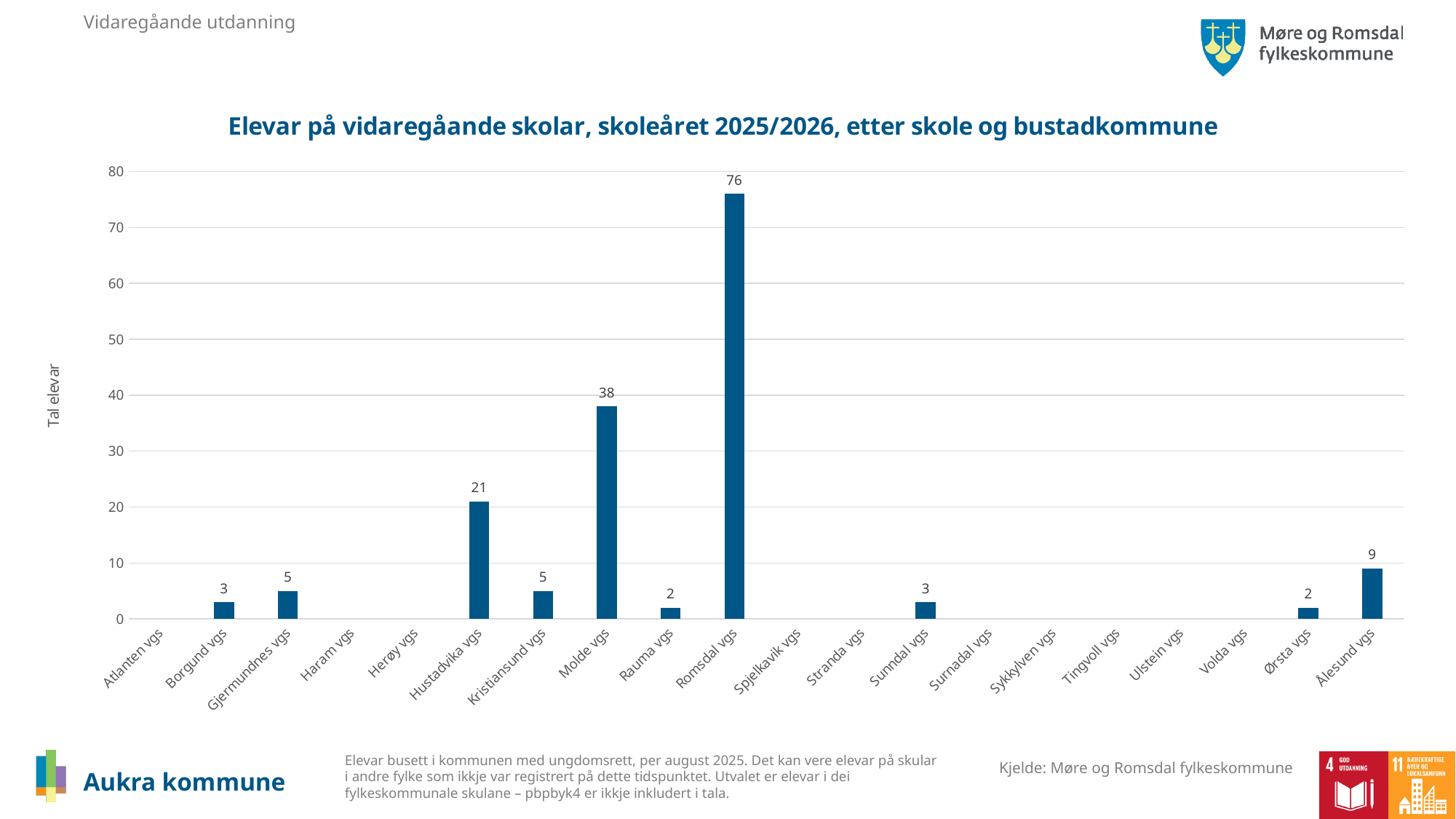
What is the difference between the values for Romsdal vgs and Molde vgs? 38 What is the value for Ålesund vgs? 9 What is the difference between the values for Hustadvika vgs and Ålesund vgs? 12 What is the label of the y axis? Tal elevar Which school has the highest number of students? Romsdal vgs Which is larger, the value for Gjermundnes vgs or the value for Borgund vgs? Gjermundnes vgs What kind of chart is shown on the slide? Bar chart How many students are shown for Hustadvika vgs? 21 How many students are shown for Romsdal vgs? 76 What is the value for Molde vgs? 38 How many schools are listed on the x axis? 20 Is the value for Molde vgs greater or less than 40? less